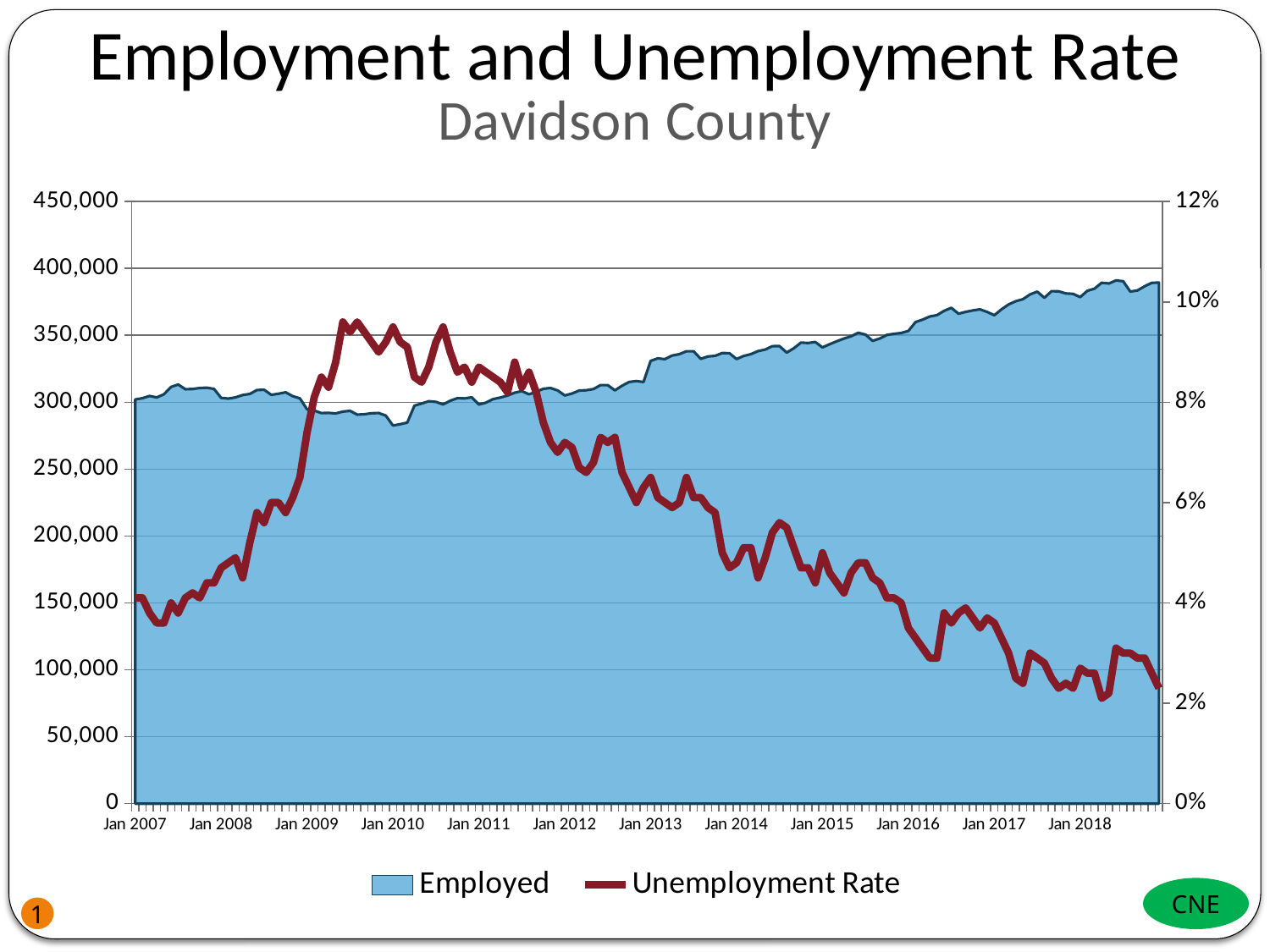
Which is higher, the Unemployment Rate in Jan 2010 or in Jan 2018? Jan 2010 Is the Employed value in Jan 2018 greater or less than 350,000? greater What is the subtitle of the chart below the main title? Davidson County How many series does the legend list? 2 Does the Employed series rise or fall from Jan 2012 to Jan 2018? rise What kind of chart is shown on the slide? area and line chart Is the Unemployment Rate in Jan 2010 greater or less than 8%? greater Does the Unemployment Rate rise or fall from Jan 2010 to Jan 2018? fall What are the two series named in the legend? Employed and Unemployment Rate Is the Unemployment Rate in Jan 2007 greater or less than 6%? less